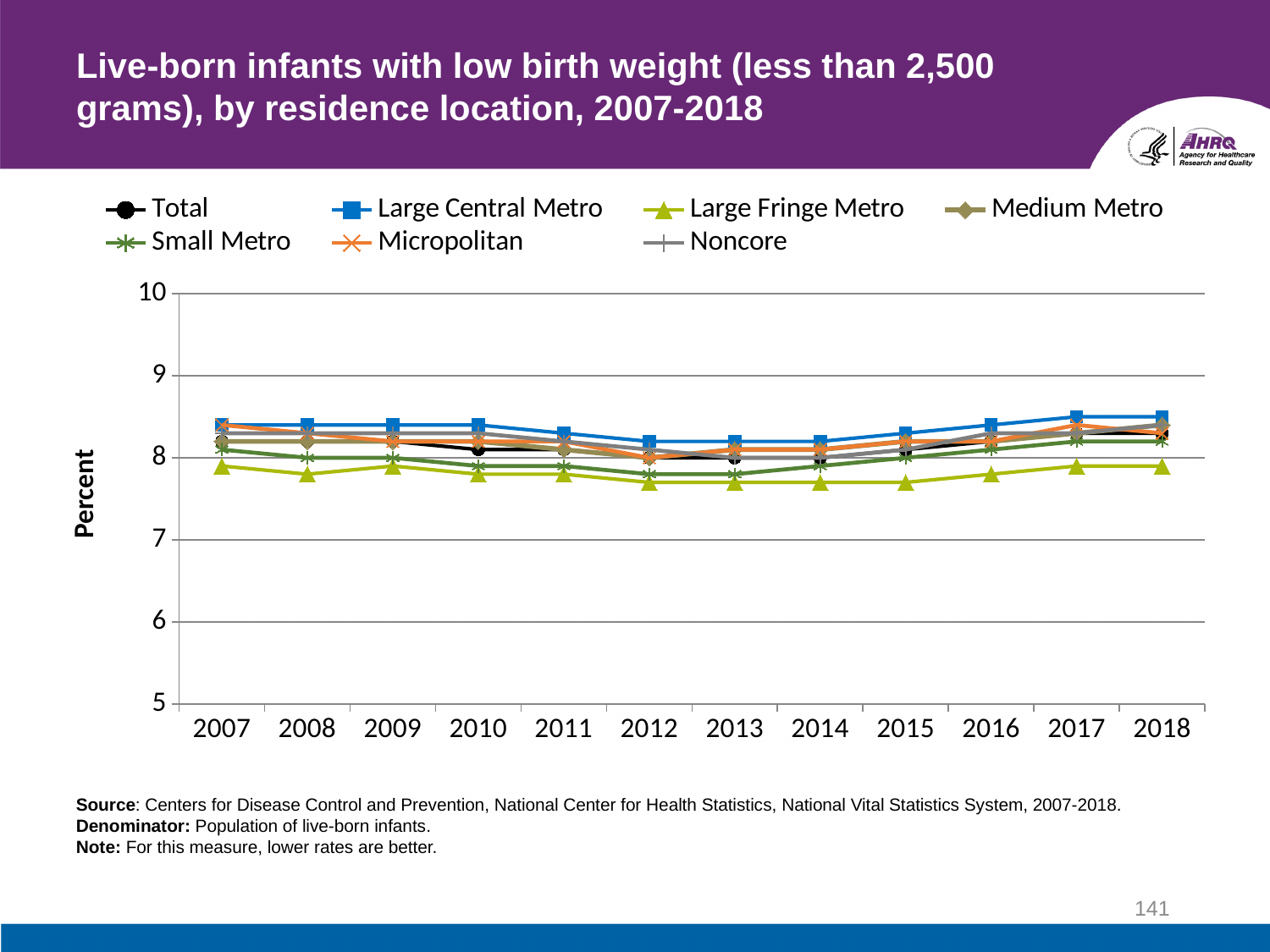
What kind of chart is shown on the slide? line chart Is the value for Total in 2007 greater or less than 9? less Is the value for Large Fringe Metro in 2018 greater or less than 8? less In 2010, which is larger: Large Central Metro or Large Fringe Metro? Large Central Metro Which residence location has the lowest value in 2018? Large Fringe Metro How many years are plotted along the x axis? 12 What is the label on the y axis? Percent Does the Large Central Metro line rise or fall from 2013 to 2017? rise Is the value for Large Fringe Metro in 2007 greater or less than 8? less Which residence location has the lowest value in 2007? Large Fringe Metro How many series does the legend list? 7